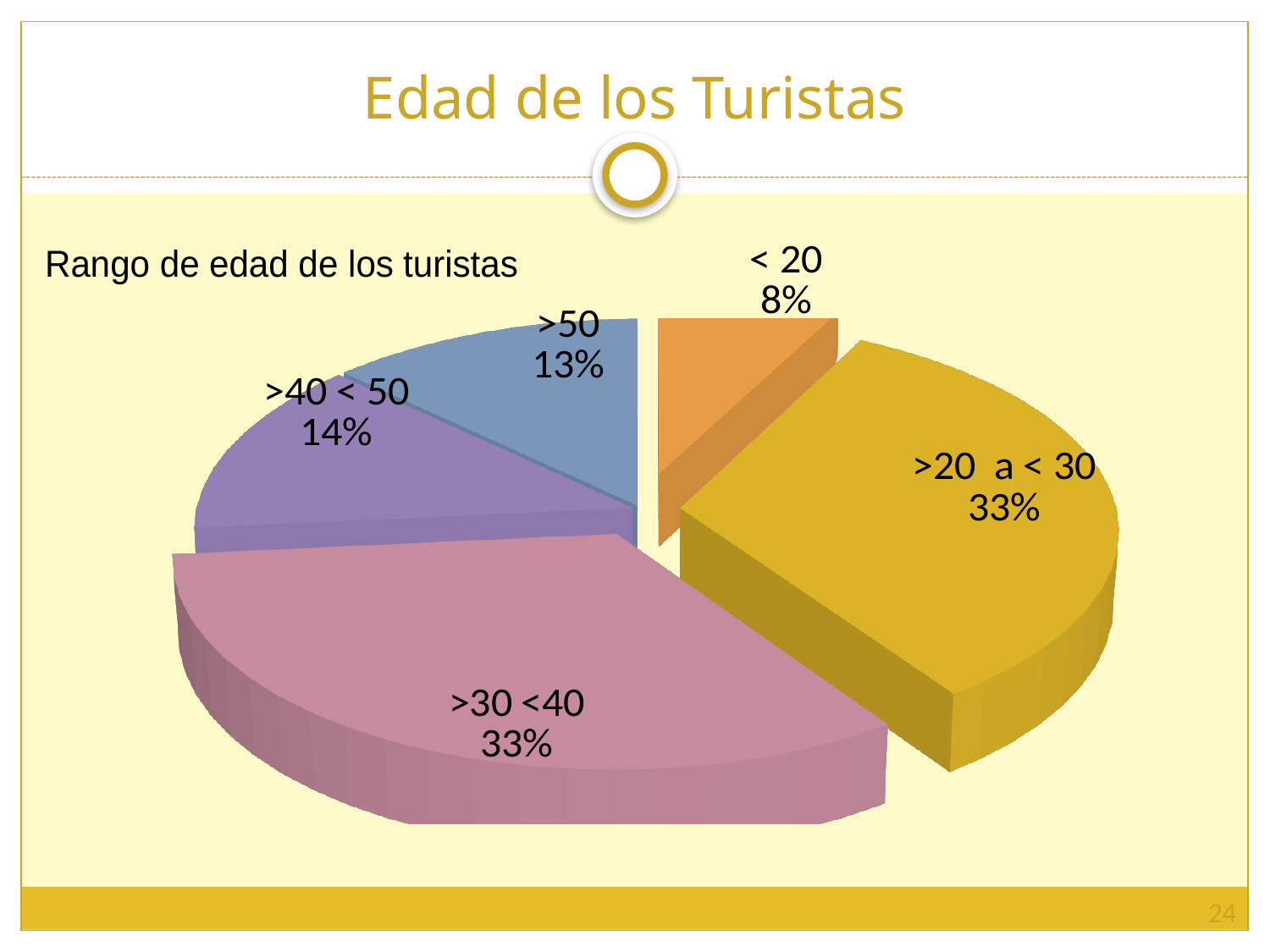
What share of tourists are in the ">20 a < 30" age range? 33% What share of tourists are in the ">50" age range? 13% Which age range has the smallest share of tourists? < 20 What colour is the slice for the ">30 <40" age range? pink What share of tourists are in the "< 20" age range? 8% What is the difference between the share for ">30 <40" and the share for "< 20"? 25% What is the difference between the share for ">40 < 50" and the share for ">50"? 1% What is the title of the chart? Rango de edad de los turistas How many slices does the pie chart have? 5 Which is larger, the share for ">40 < 50" or the share for "< 20"? >40 < 50 What kind of chart is shown on the slide? pie chart